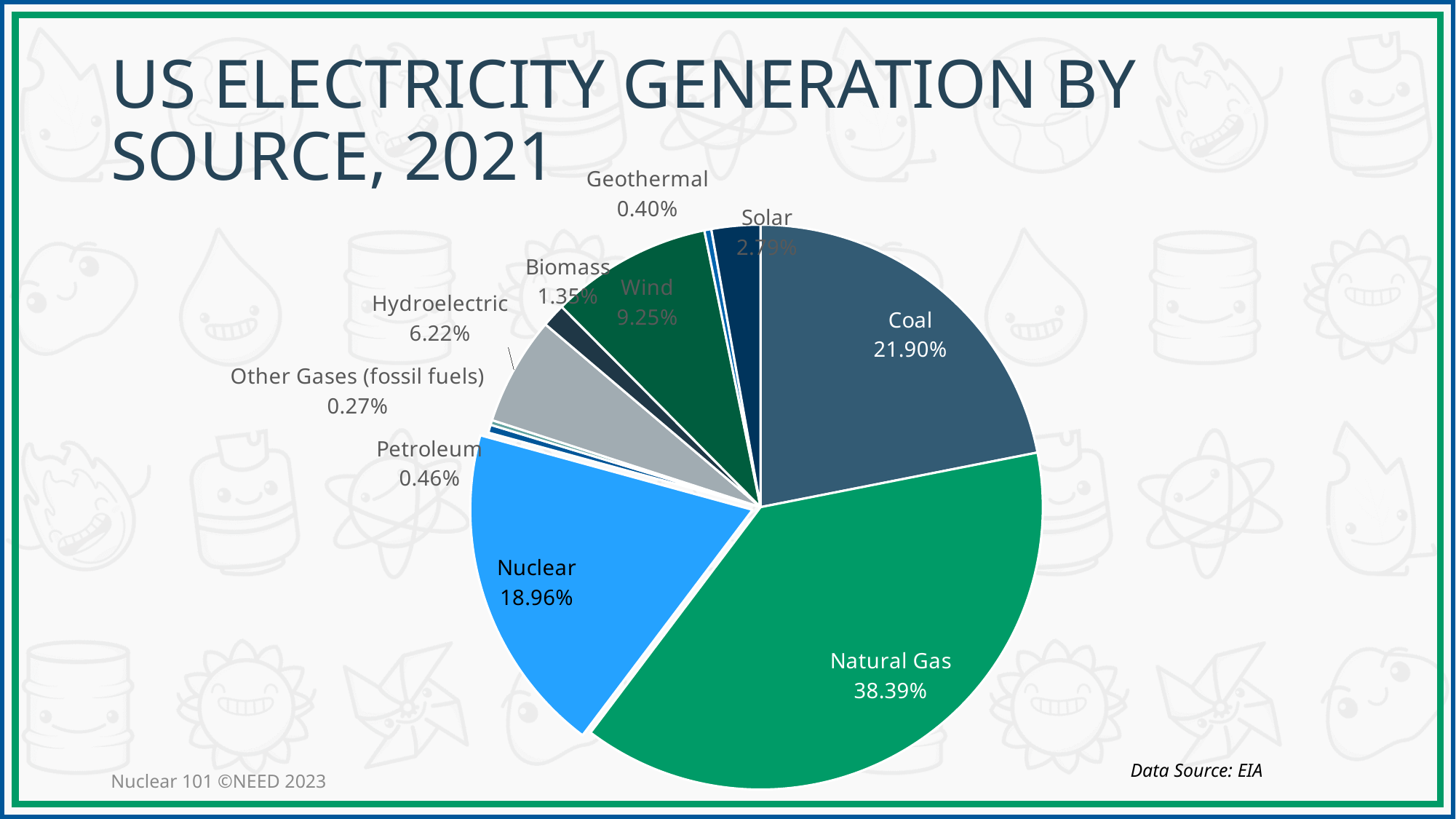
What is the difference in percentage points between Coal and Nuclear? 2.94 What is the combined share of Coal and Natural Gas? 60.29% Which source has the smallest slice of the pie? Other Gases (fossil fuels) Which source has the largest slice of the pie? Natural Gas What percentage is shown for Geothermal? 0.40% What kind of chart is shown on the slide? Pie chart What share of US electricity generation in 2021 came from Natural Gas? 38.39% What percentage is shown for Hydroelectric? 6.22% What is the title of the chart? US Electricity Generation by Source, 2021 What percentage is shown for Nuclear? 18.96% How many sources are shown in the pie chart? 10 Which is larger, the share for Wind or the share for Hydroelectric? Wind